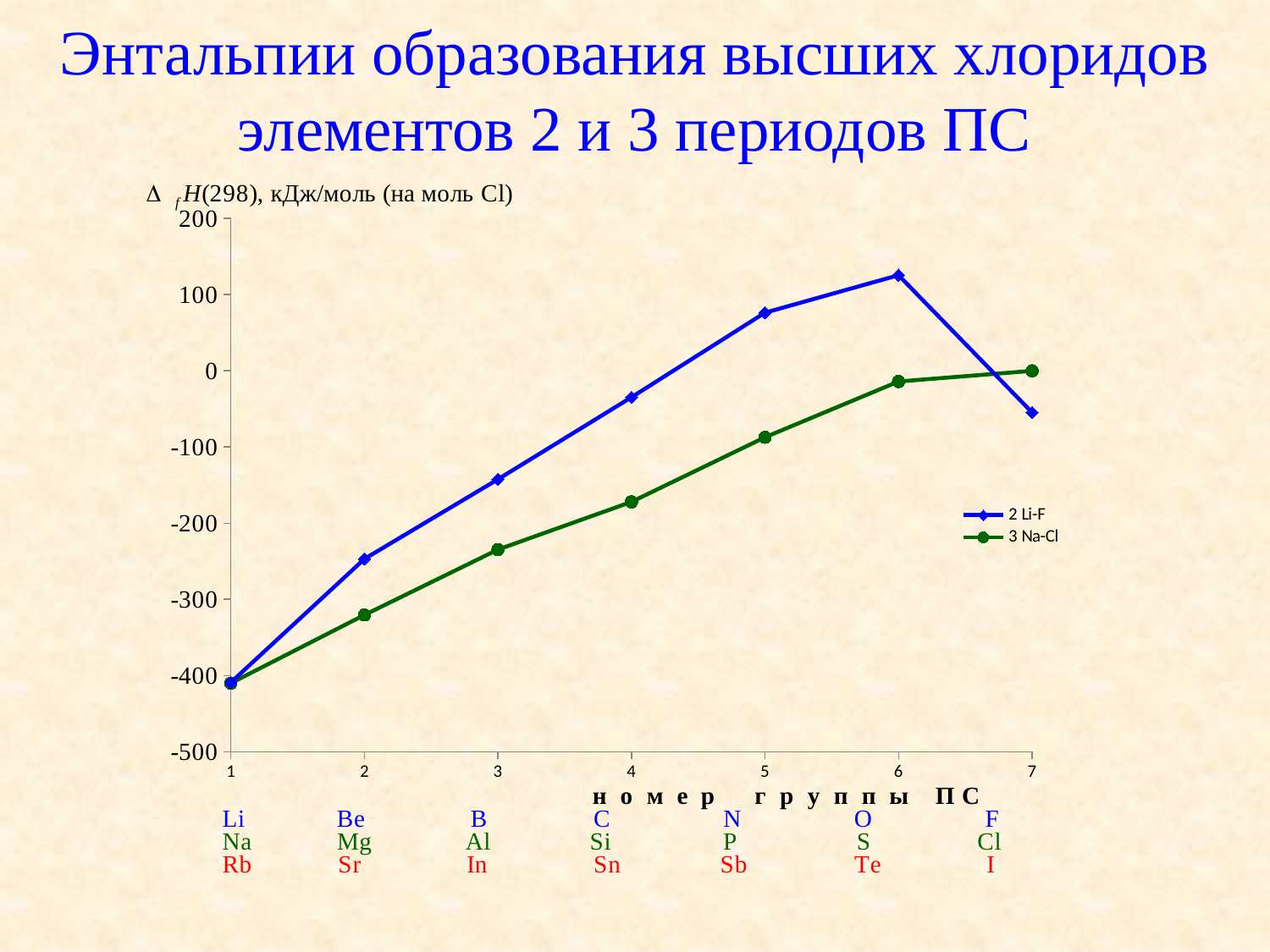
Is the value of the 2 Li-F series at group 7 greater or less than 0? less Is the value of the 3 Na-Cl series at group 2 greater or less than -300? less At group 5, which series has the larger value, 2 Li-F or 3 Na-Cl? 2 Li-F What are the two series named in the legend? 2 Li-F and 3 Na-Cl At which group number does the 2 Li-F series reach its highest value? 6 How many series does the legend list? 2 Is the value of the 2 Li-F series at group 6 greater or less than 100? greater What kind of chart is shown on the slide? line chart Do the values of the 3 Na-Cl series rise or fall as the group number increases from 1 to 7? rise How many group numbers (points) are plotted along the x axis for each series? 7 At which group number does the 3 Na-Cl series have its lowest value? 1